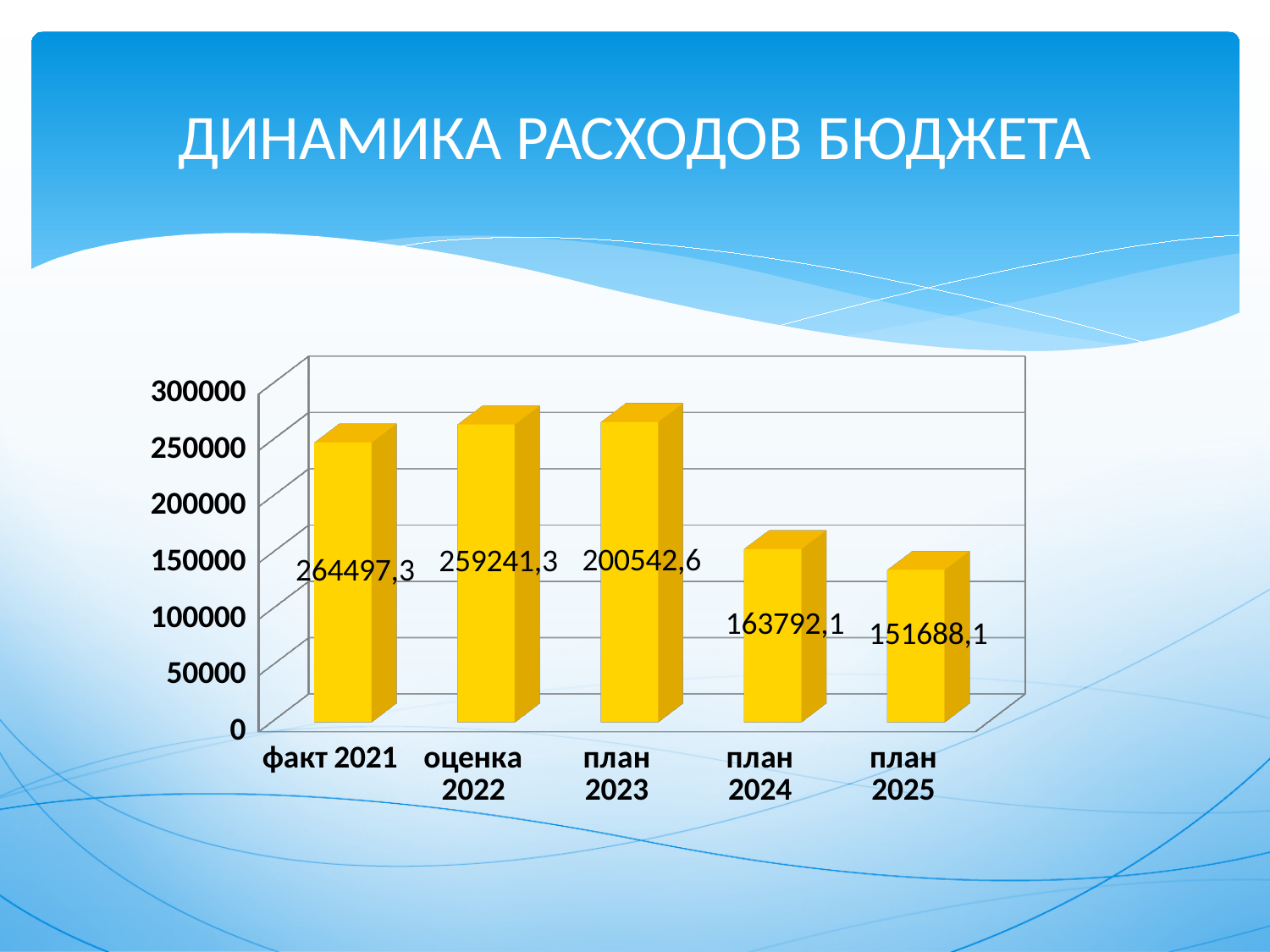
What is the value for план 2024? 163792,1 What is the difference between the values for план 2024 and план 2025? 12104 What kind of chart is shown on the slide? bar chart Is the value for план 2025 greater or less than 200000? less What is the value for факт 2021? 264497,3 What is the value for план 2023? 200542,6 What is the value for оценка 2022? 259241,3 What is the title of the slide? ДИНАМИКА РАСХОДОВ БЮДЖЕТА Which category has the lowest value? план 2025 What is the value for план 2025? 151688,1 Which is larger, the value for план 2023 or the value for план 2024? план 2023 How many categories are shown on the x axis? 5